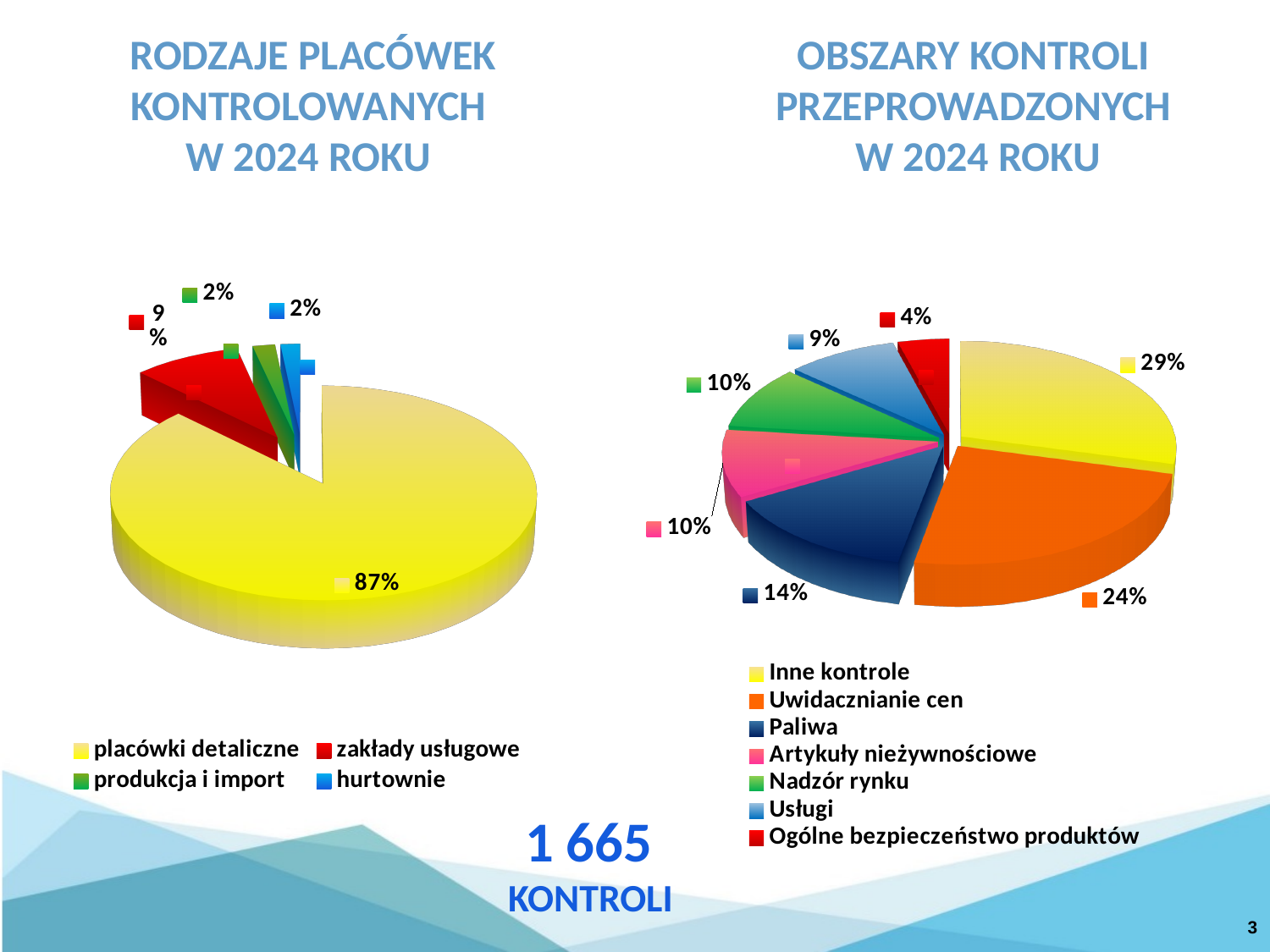
In the chart titled 'OBSZARY KONTROLI PRZEPROWADZONYCH W 2024 ROKU', how many categories does the legend list? 7 What kind of chart is the one titled 'RODZAJE PLACÓWEK KONTROLOWANYCH W 2024 ROKU'? Pie chart In the chart titled 'RODZAJE PLACÓWEK KONTROLOWANYCH W 2024 ROKU', what share is shown for 'zakłady usługowe'? 9% In the chart titled 'OBSZARY KONTROLI PRZEPROWADZONYCH W 2024 ROKU', what share is shown for 'Paliwa'? 14% In the chart titled 'OBSZARY KONTROLI PRZEPROWADZONYCH W 2024 ROKU', what share is shown for 'Uwidacznianie cen'? 24% In the chart titled 'RODZAJE PLACÓWEK KONTROLOWANYCH W 2024 ROKU', what share is shown for 'placówki detaliczne'? 87% In the chart titled 'RODZAJE PLACÓWEK KONTROLOWANYCH W 2024 ROKU', which category has the largest share? placówki detaliczne In the chart titled 'OBSZARY KONTROLI PRZEPROWADZONYCH W 2024 ROKU', which category has the smallest share? Ogólne bezpieczeństwo produktów In the chart titled 'OBSZARY KONTROLI PRZEPROWADZONYCH W 2024 ROKU', what is the difference in percentage points between 'Inne kontrole' and 'Uwidacznianie cen'? 5 percentage points In the chart titled 'RODZAJE PLACÓWEK KONTROLOWANYCH W 2024 ROKU', how many categories does the legend list? 4 In the chart titled 'OBSZARY KONTROLI PRZEPROWADZONYCH W 2024 ROKU', which category has the largest share? Inne kontrole In the chart titled 'OBSZARY KONTROLI PRZEPROWADZONYCH W 2024 ROKU', which is larger: 'Paliwa' or 'Usługi'? Paliwa